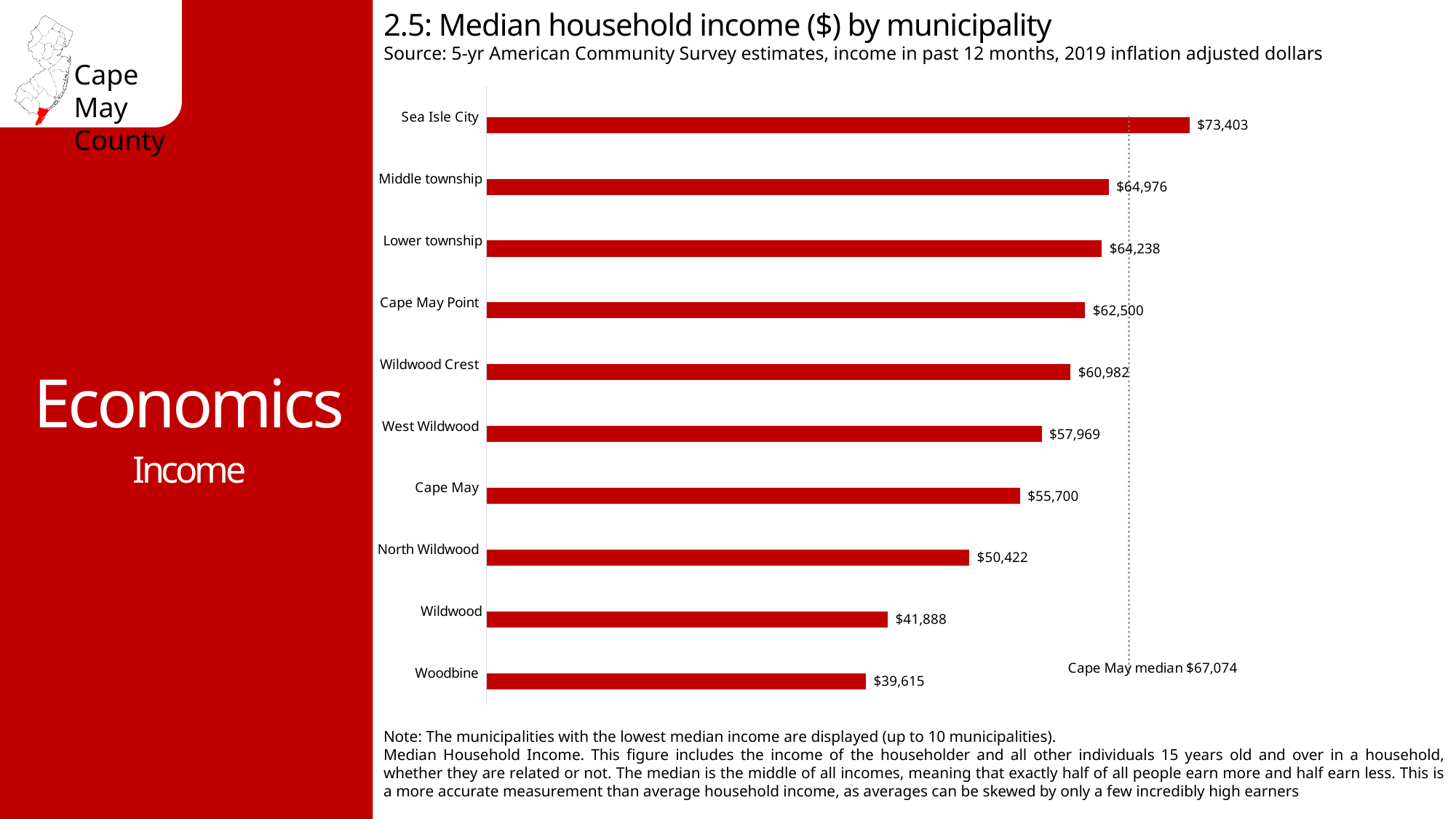
What is the median household income for Woodbine? $39,615 How many municipalities are shown on the chart? 10 What kind of chart is used to show median household income by municipality? Bar chart Which has a higher median household income, Cape May Point or West Wildwood? Cape May Point What is the difference in median household income between Wildwood and Woodbine? $2,273 What is the difference in median household income between Sea Isle City and Woodbine? $33,788 What is the median household income for Sea Isle City? $73,403 What is the median household income for North Wildwood? $50,422 What value does the dotted reference line on the chart represent? Cape May median $67,074 Do the median household income values increase or decrease going from the top bar to the bottom bar? Decrease Which municipality has the highest median household income on the chart? Sea Isle City Which municipality has the lowest median household income on the chart? Woodbine